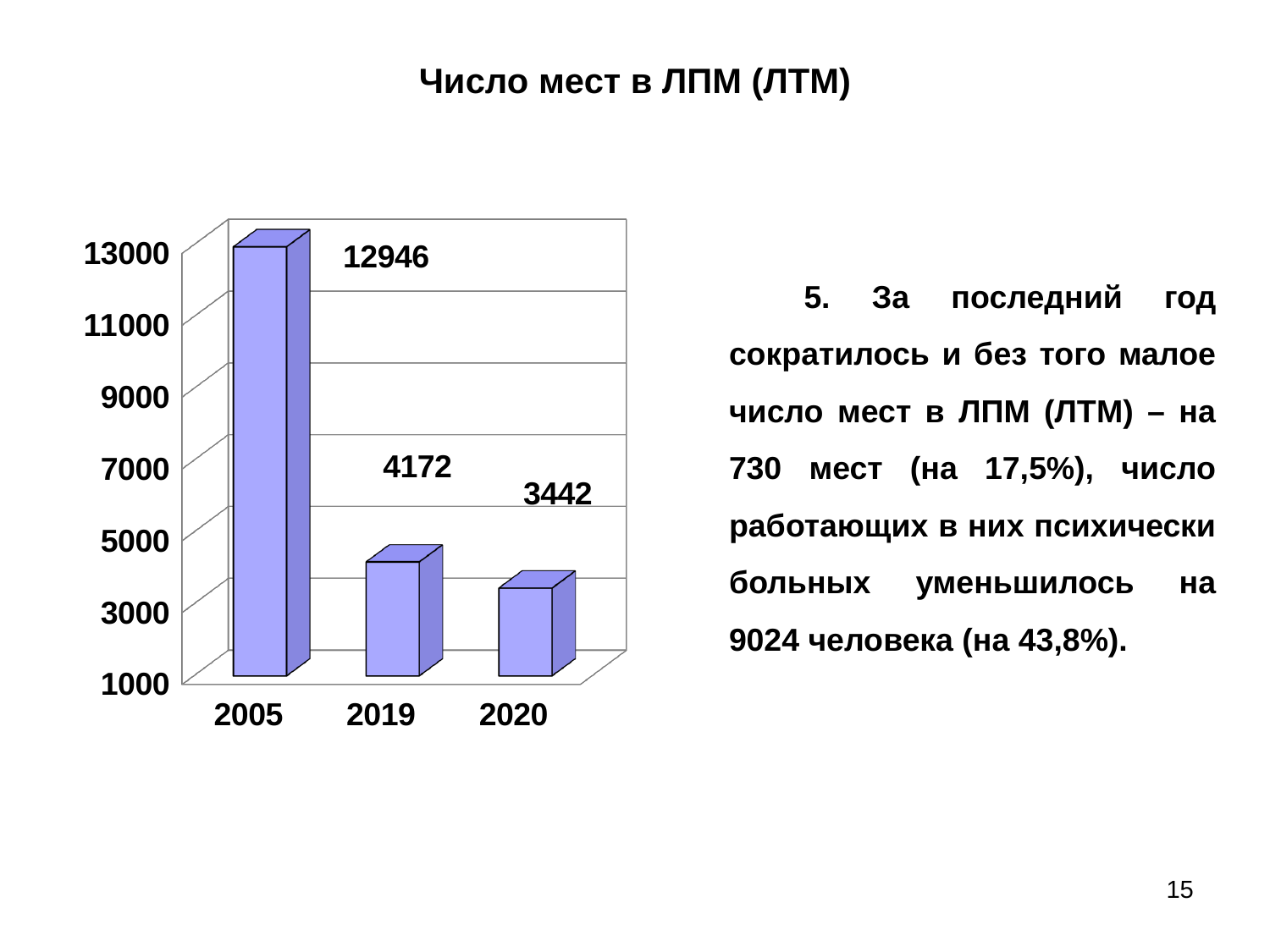
How many years are shown on the x axis? 3 What is the difference between the values for 2019 and 2020? 730 What is the value for 2019? 4172 What kind of chart is this? bar chart What is the value for 2020? 3442 Which year has the highest value? 2005 What is the value for 2005? 12946 Do the values rise or fall from 2005 to 2020? fall Is the value for 2019 greater or less than 5000? less Which is larger, the value for 2019 or the value for 2020? 2019 What is the difference between the values for 2005 and 2019? 8774 Which year has the lowest value? 2020